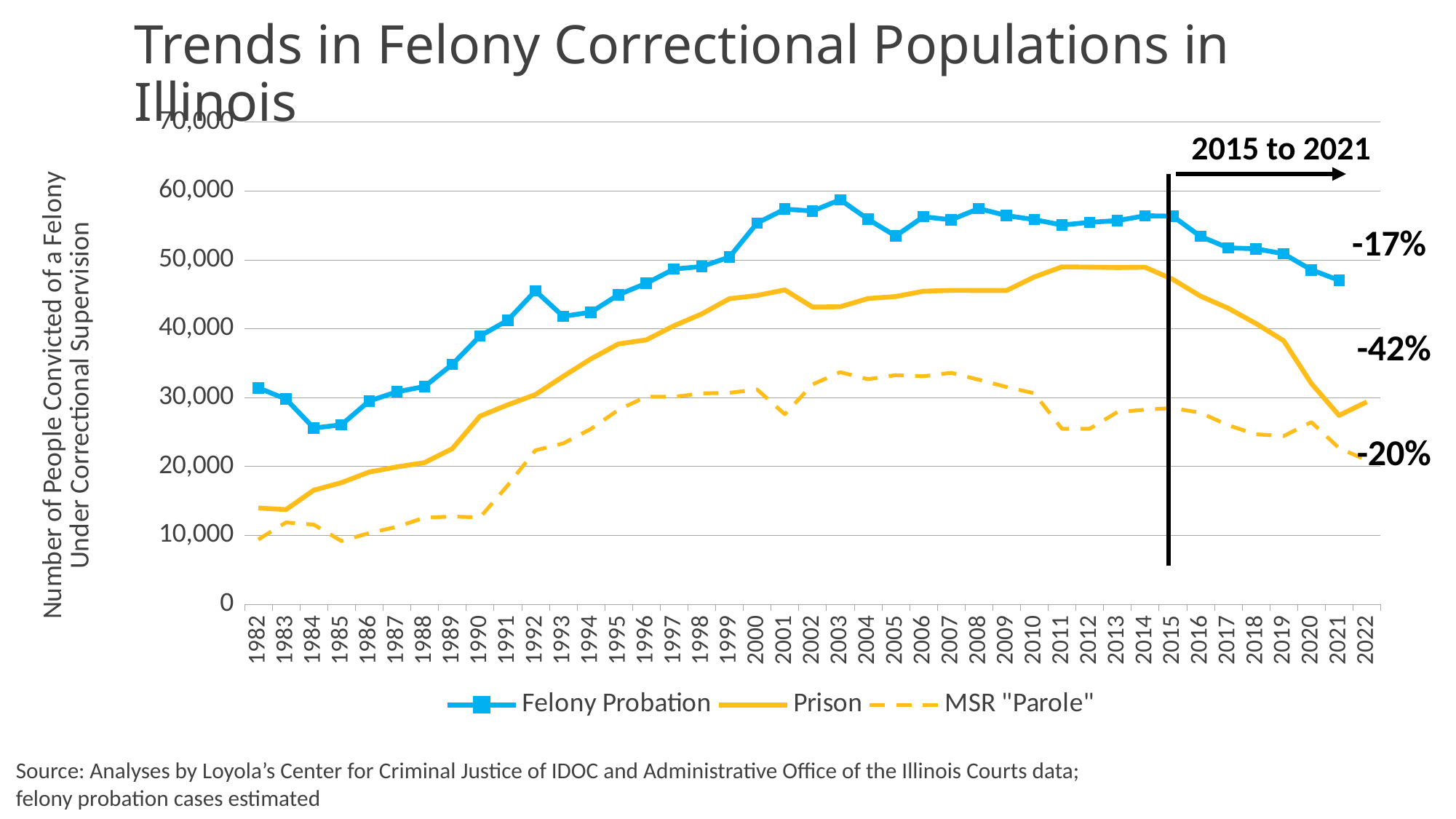
Is the Prison value for 2021 greater or less than 30,000? less What are the three series named in the legend? Felony Probation, Prison, MSR "Parole" Which series has the highest value in 2000? Felony Probation In 2010, which is larger: the Felony Probation value or the Prison value? Felony Probation Is the Felony Probation value for 2003 greater or less than 50,000? greater What percentage change is annotated for the Prison series from 2015 to 2021? -42% What kind of chart is shown on the slide? line chart What percentage change is annotated for the MSR "Parole" series from 2015 to 2021? -20% What percentage change is annotated for the Felony Probation series from 2015 to 2021? -17% How many series does the legend list? 3 Is the Prison value for 1982 greater or less than 20,000? less Does the Prison series rise or fall between 2015 and 2021? fall